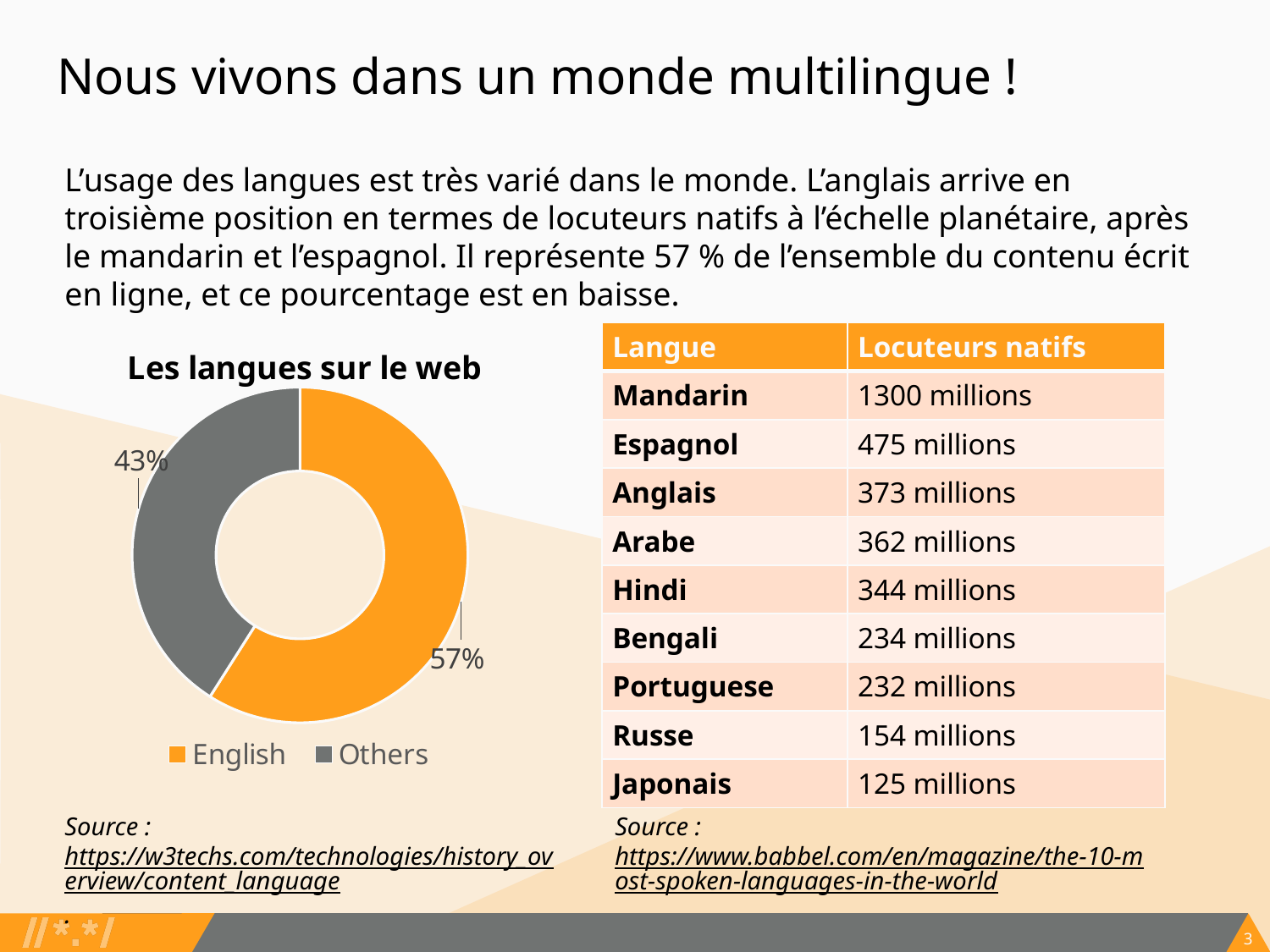
What share of the chart "Les langues sur le web" is taken by the Others slice? 43% Which category has the largest share in the chart "Les langues sur le web"? English What colour is the English slice in the chart "Les langues sur le web"? Orange Which category has the smallest share in the chart "Les langues sur le web"? Others What percentage does the Others slice represent in the chart "Les langues sur le web"? 43% How many categories are shown in the chart "Les langues sur le web"? 2 What kind of chart is "Les langues sur le web"? Doughnut (pie) chart What percentage does the English slice represent in the chart "Les langues sur le web"? 57% By how many percentage points does English exceed Others in the chart "Les langues sur le web"? 14 percentage points How many entries does the legend of the chart "Les langues sur le web" list? 2 In the chart "Les langues sur le web", is the share for English larger or smaller than the share for Others? larger What is the title of the chart on the slide? Les langues sur le web